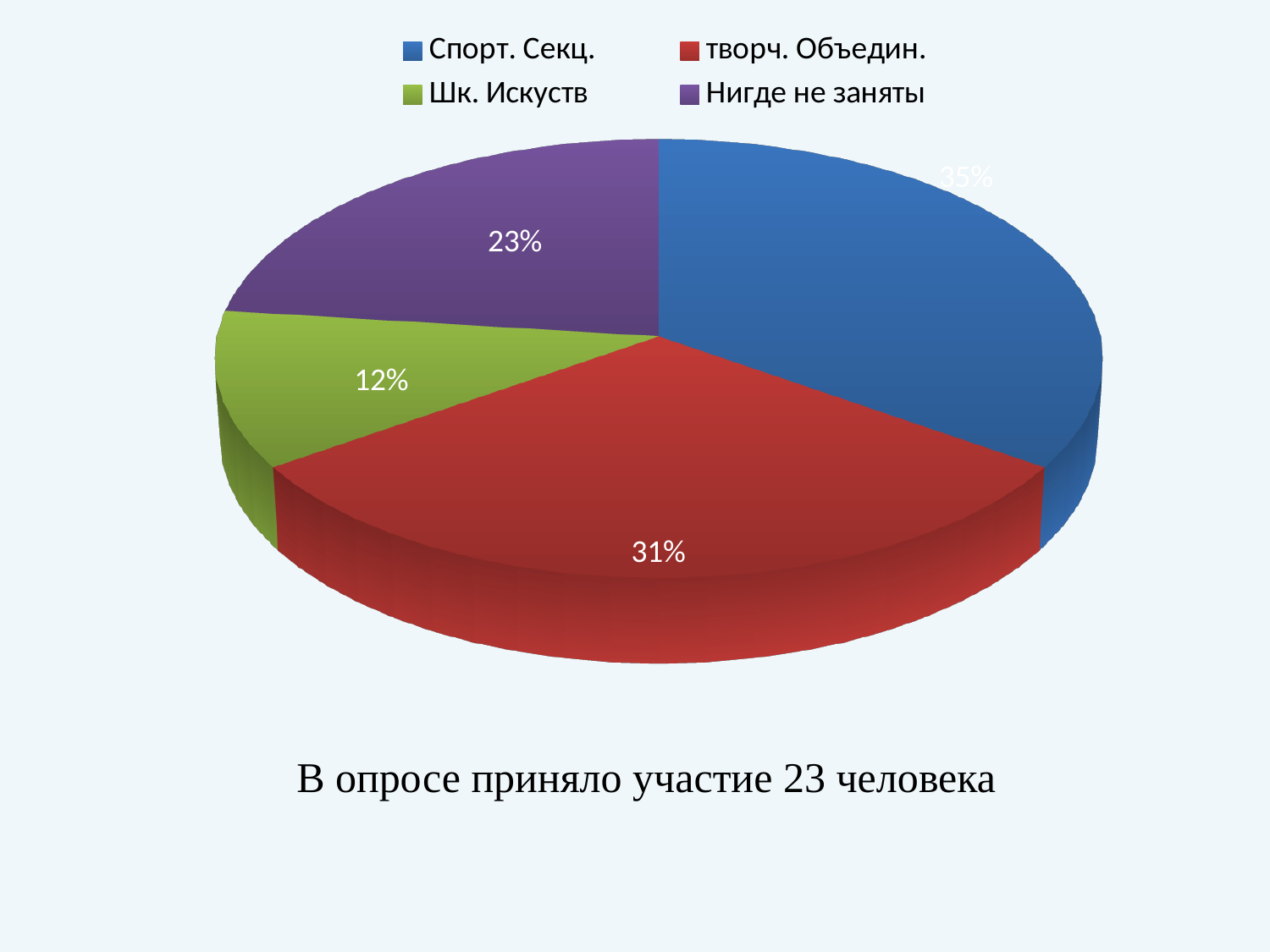
What share of the pie does the "творч. Объедин." slice represent? 31% What is the difference in percentage points between the "Спорт. Секц." and "Шк. Искуств" slices? 23 According to the text below the chart, how many people took part in the survey? 23 What colour is the "творч. Объедин." slice? Red Which category has the largest slice of the pie? Спорт. Секц. What share of the pie does the "Шк. Искуств" slice represent? 12% Which category has the smallest slice of the pie? Шк. Искуств What share of the pie does the "Спорт. Секц." slice represent? 35% Which is larger, the "Нигде не заняты" slice or the "Шк. Искуств" slice? Нигде не заняты What kind of chart is shown on the slide? Pie chart How many slices does the pie chart have? 4